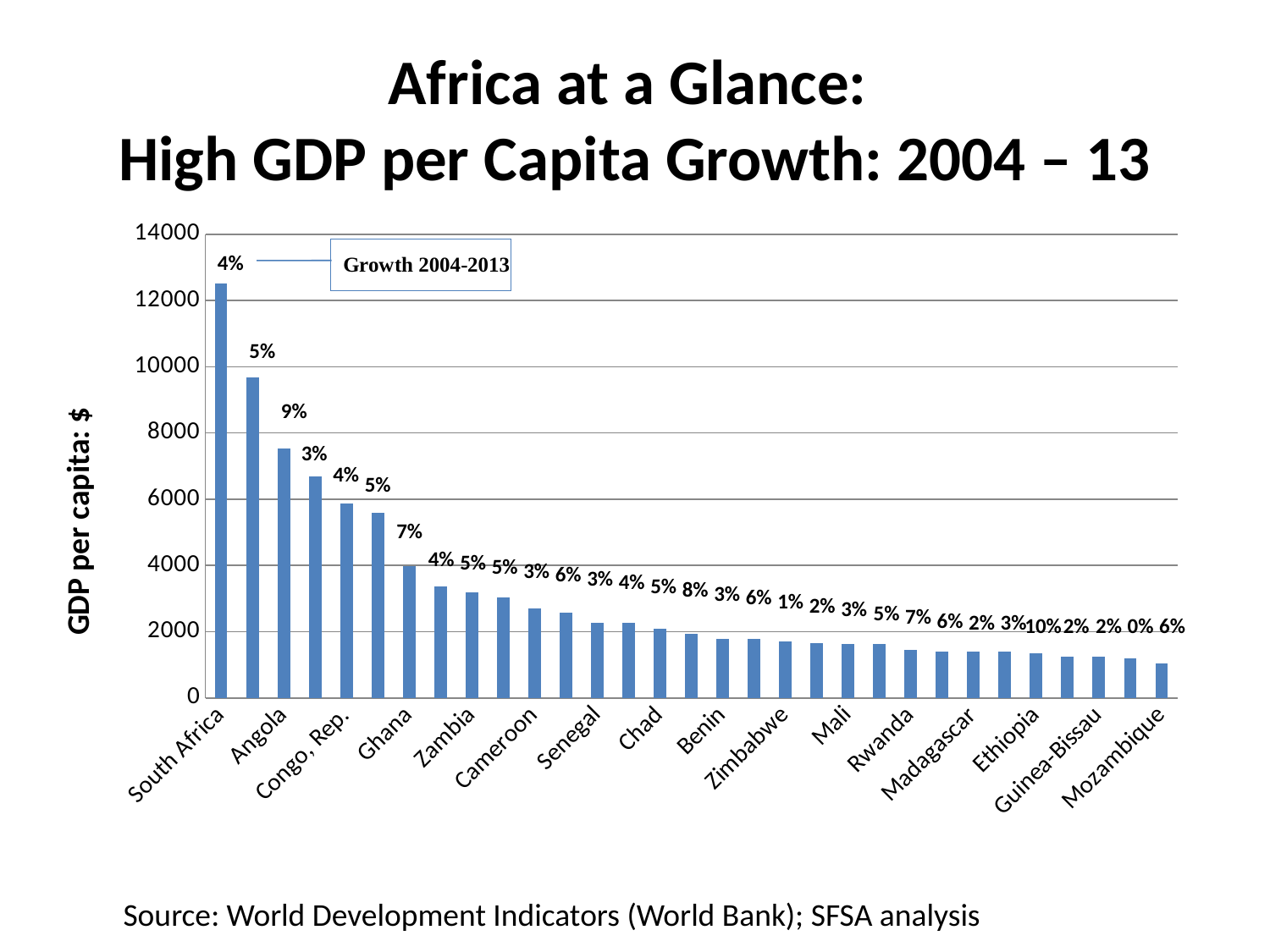
Which country has the lowest GDP per capita in the chart? Mozambique What growth rate for 2004-2013 is shown above the Ghana bar? 7% What growth rate for 2004-2013 is shown above the Angola bar? 9% Is the GDP per capita for Mozambique greater or less than 2000? less Do the GDP per capita values rise or fall moving from left to right along the x axis? Fall What growth rate for 2004-2013 is shown above the Ethiopia bar? 10% What growth rate for 2004-2013 is shown above the Zimbabwe bar? 1% What kind of chart is shown on the slide? Bar chart Is the GDP per capita for Angola greater or less than 6000? greater What is the label on the vertical axis of the chart? GDP per capita: $ Is the GDP per capita for South Africa greater or less than 12000? greater Which country has the highest GDP per capita in the chart? South Africa